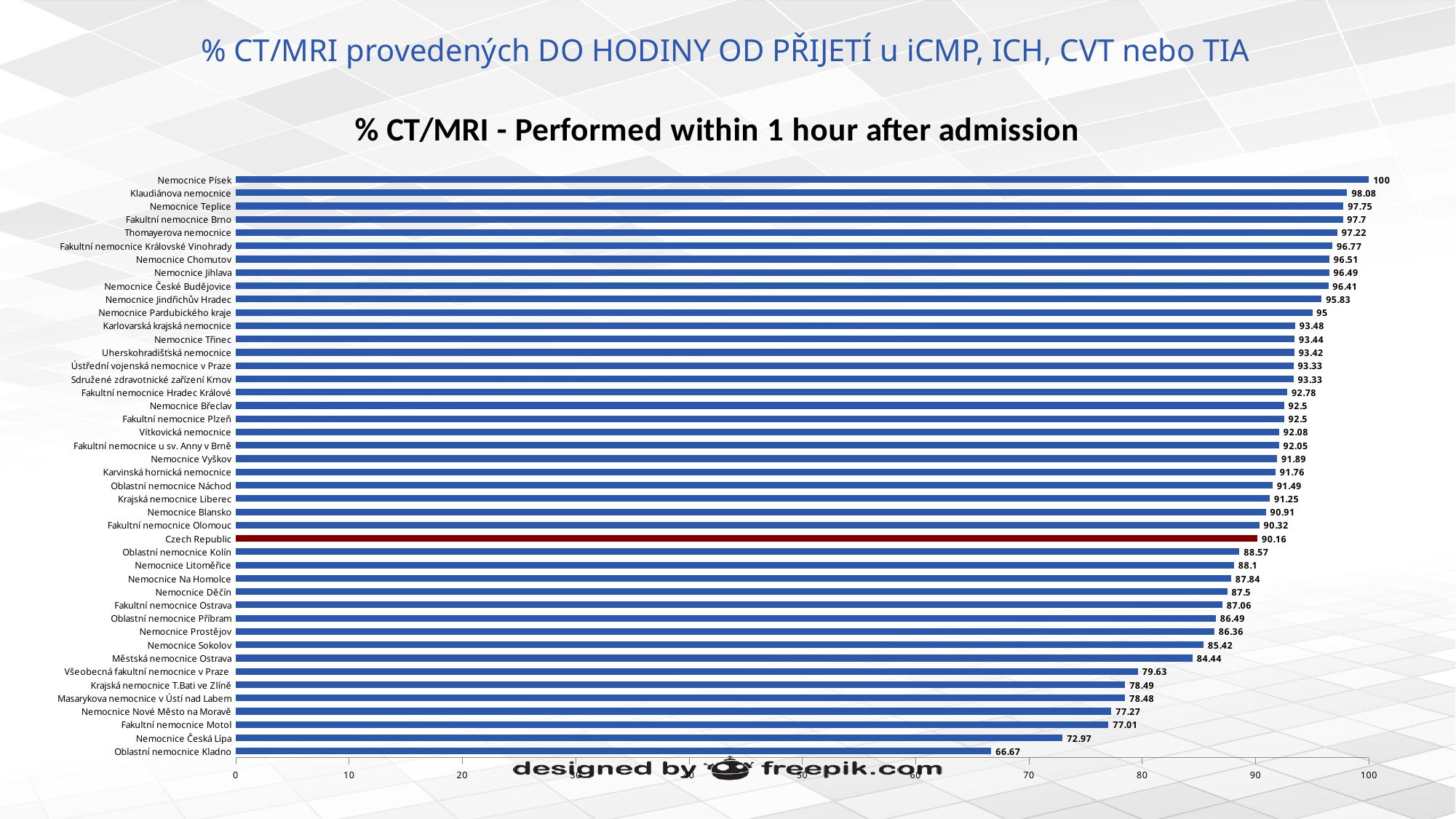
Which hospital has the lowest value? Oblastní nemocnice Kladno Is the value for Všeobecná fakultní nemocnice v Praze greater or less than 80? less What is the value for Nemocnice Písek? 100 Which bar is drawn in a different colour (dark red) from the others? Czech Republic What is the difference between the values for Nemocnice Písek and Oblastní nemocnice Kladno? 33.33 What is the value for Nemocnice Na Homolce? 87.84 Which hospital has the highest value? Nemocnice Písek How many bars are plotted in the chart? 44 Which has a larger value, Nemocnice Česká Lípa or Fakultní nemocnice Brno? Fakultní nemocnice Brno What is the value for Fakultní nemocnice Motol? 77.01 What is the value for Czech Republic? 90.16 What kind of chart is shown on the slide? bar chart